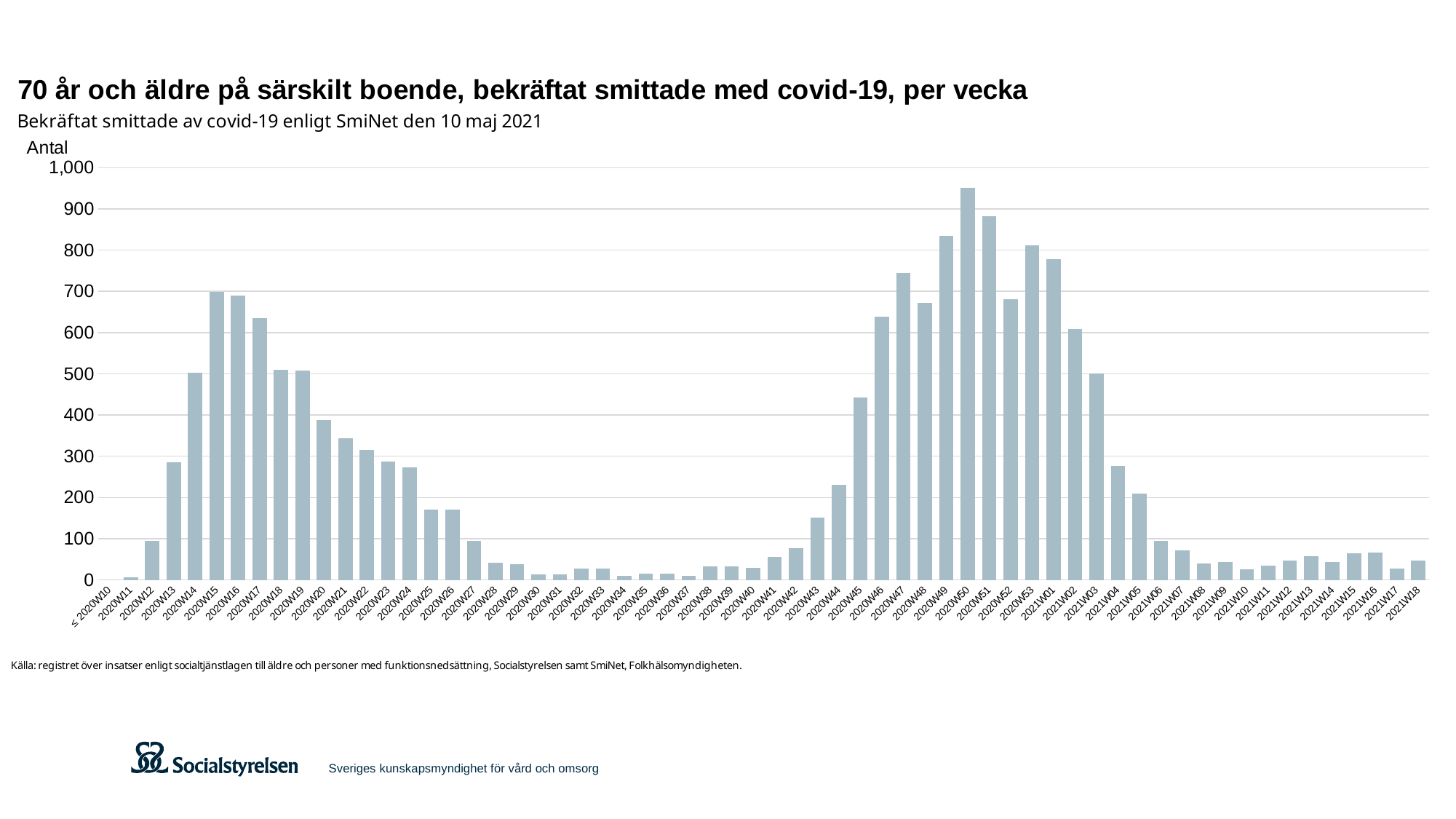
How many weekly bars are plotted in the chart? 62 Is the value for 2020W47 greater or less than 700? greater Which is larger, the value for 2020W50 or the value for 2020W15? 2020W50 Is the value for 2020W20 greater or less than 400? less Do the values rise or fall from 2020W50 to 2021W06? fall Is the value for 2020W45 greater or less than 400? greater Which is larger, the value for 2021W01 or the value for 2021W02? 2021W01 Which week has the highest number of confirmed cases? 2020W50 What kind of chart is shown on the slide? bar chart What label is shown on the vertical axis of the chart? Antal